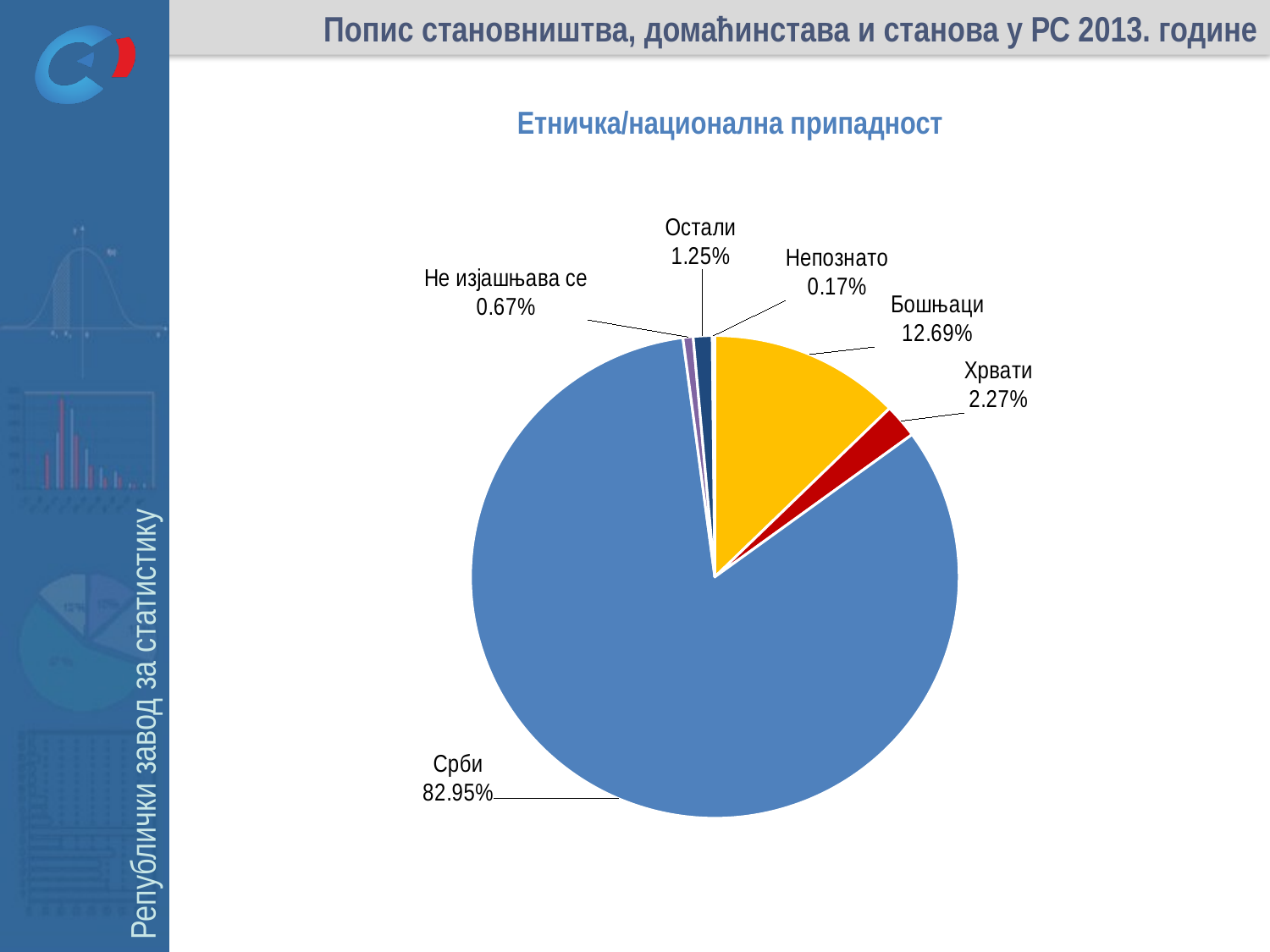
What share of the pie does Срби have? 82.95% What is the value shown for Бошњаци? 12.69% Which category has the smallest slice of the pie? Непознато What is the difference between the values for Бошњаци and Хрвати? 10.42% How many categories are shown in the pie chart? 6 What is the value shown for Хрвати? 2.27% What is the value shown for Остали? 1.25% What is the value shown for Непознато? 0.17% What kind of chart is shown on the slide? Pie chart What is the value shown for Не изјашњава се? 0.67% Which category has the largest slice of the pie? Срби Which is larger, the value for Остали or the value for Не изјашњава се? Остали